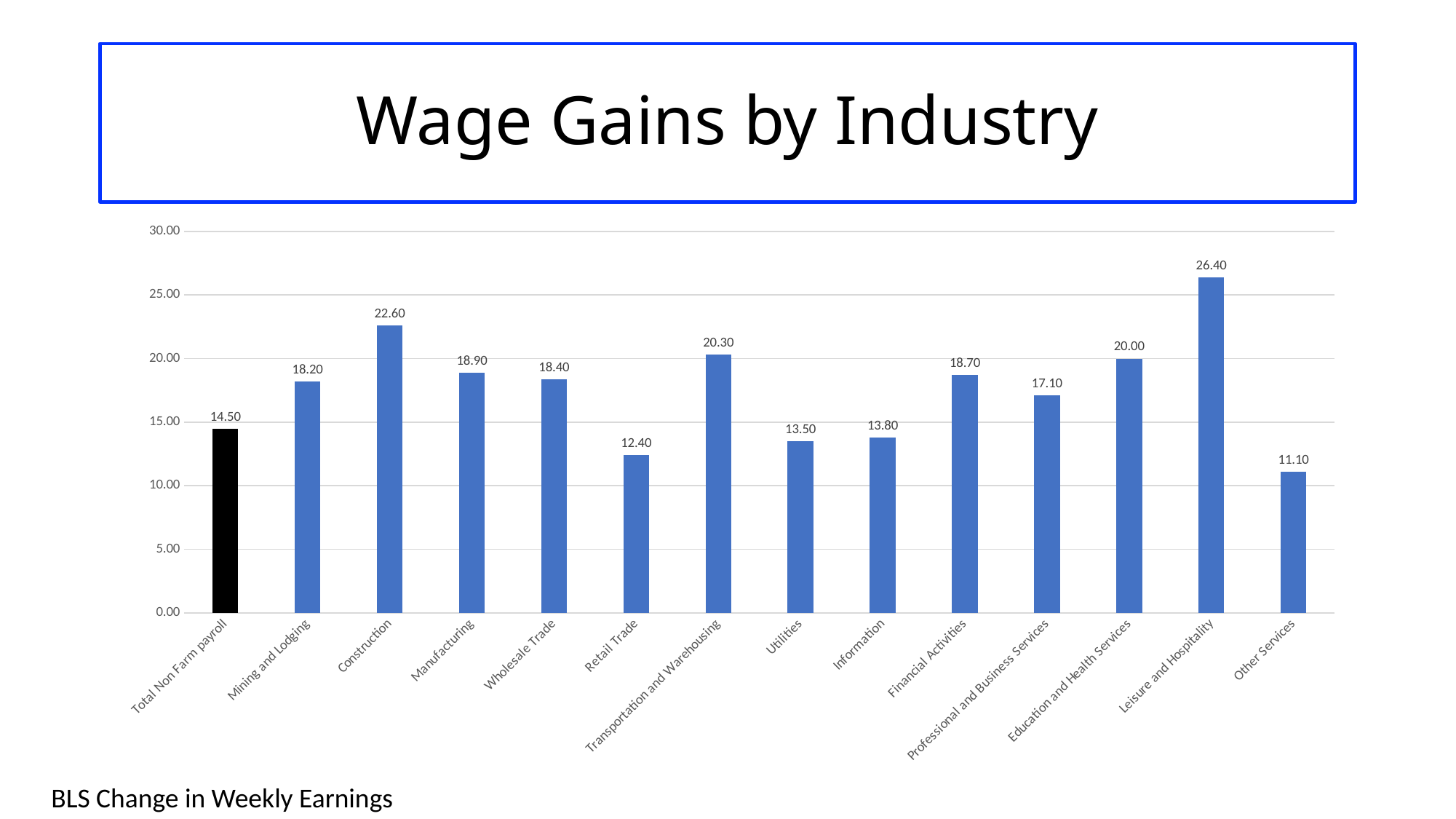
What is the title of the slide? Wage Gains by Industry Is the value for Retail Trade greater or less than 15.00? less What is the difference between the values for Leisure and Hospitality and Construction? 3.80 How many categories are shown on the x axis? 14 What is the value for Total Non Farm payroll? 14.50 What is the value for Utilities? 13.50 Which bar is coloured black rather than blue? Total Non Farm payroll Which category has the lowest value? Other Services What is the value for Construction? 22.60 Which category has the highest value? Leisure and Hospitality What kind of chart is shown on the slide? Bar chart Which is larger, the value for Manufacturing or the value for Wholesale Trade? Manufacturing